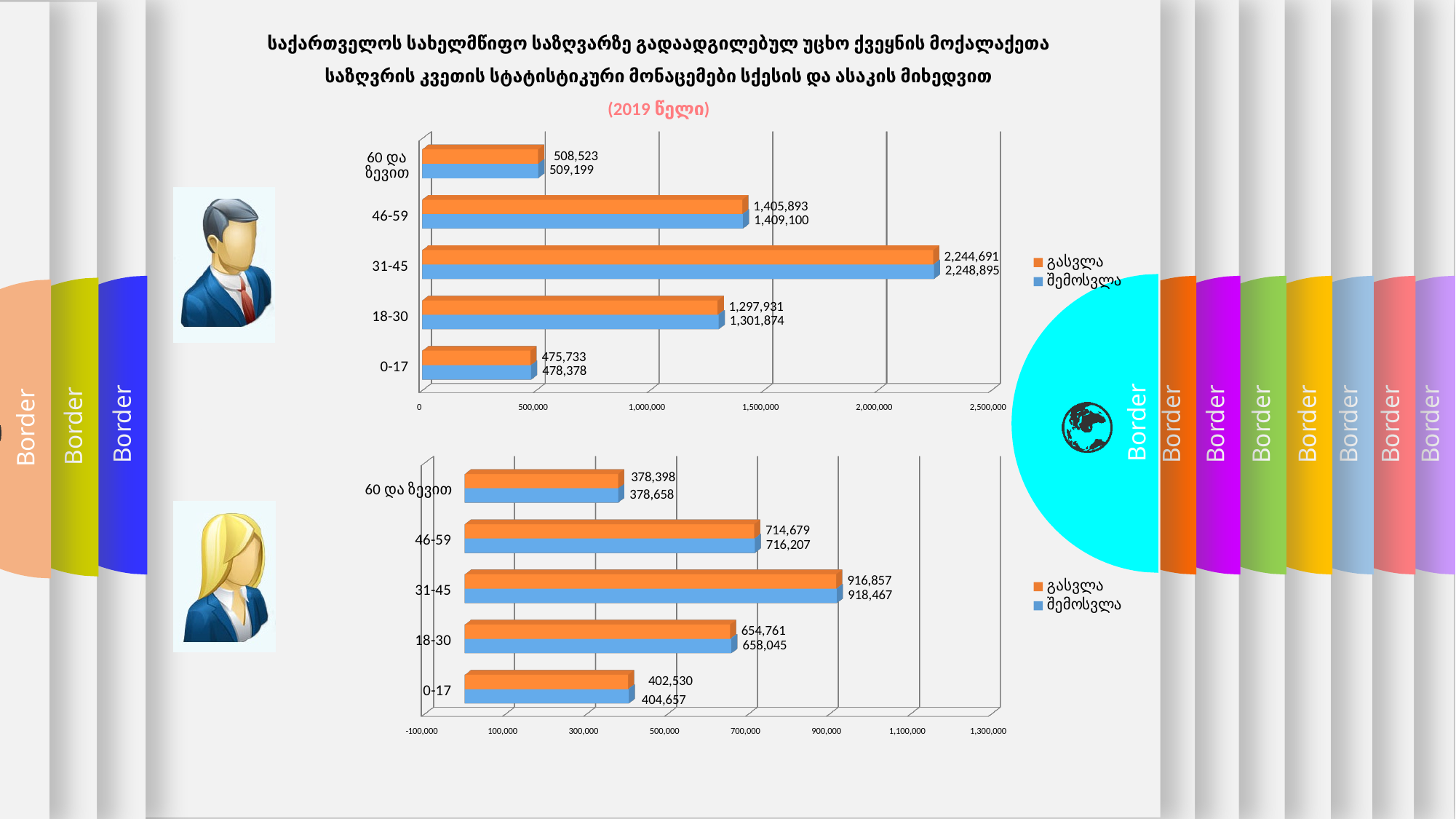
In the bottom chart, what is the difference between the შემოსვლა and გასვლა values for the 0-17 age group? 2,127 In the bottom chart, which age group has the lowest შემოსვლა value? 60 და ზევით How many age groups are shown in the bottom chart? 5 What type of chart is the bottom chart? Bar chart How many series does the legend of the top chart list? 2 In the bottom chart, what is the გასვლა value for the 18-30 age group? 654,761 In the top chart, what is the გასვლა value for the 31-45 age group? 2,244,691 In the top chart, what is the difference between the შემოსვლა and გასვლა values for the 46-59 age group? 3,207 In the top chart, what is the შემოსვლა value for the 0-17 age group? 478,378 In the top chart, which is larger: the გასვლა value for 18-30 or the გასვლა value for 46-59? 46-59 In the bottom chart, what is the შემოსვლა value for the 46-59 age group? 716,207 In the top chart, which age group has the highest გასვლა value? 31-45